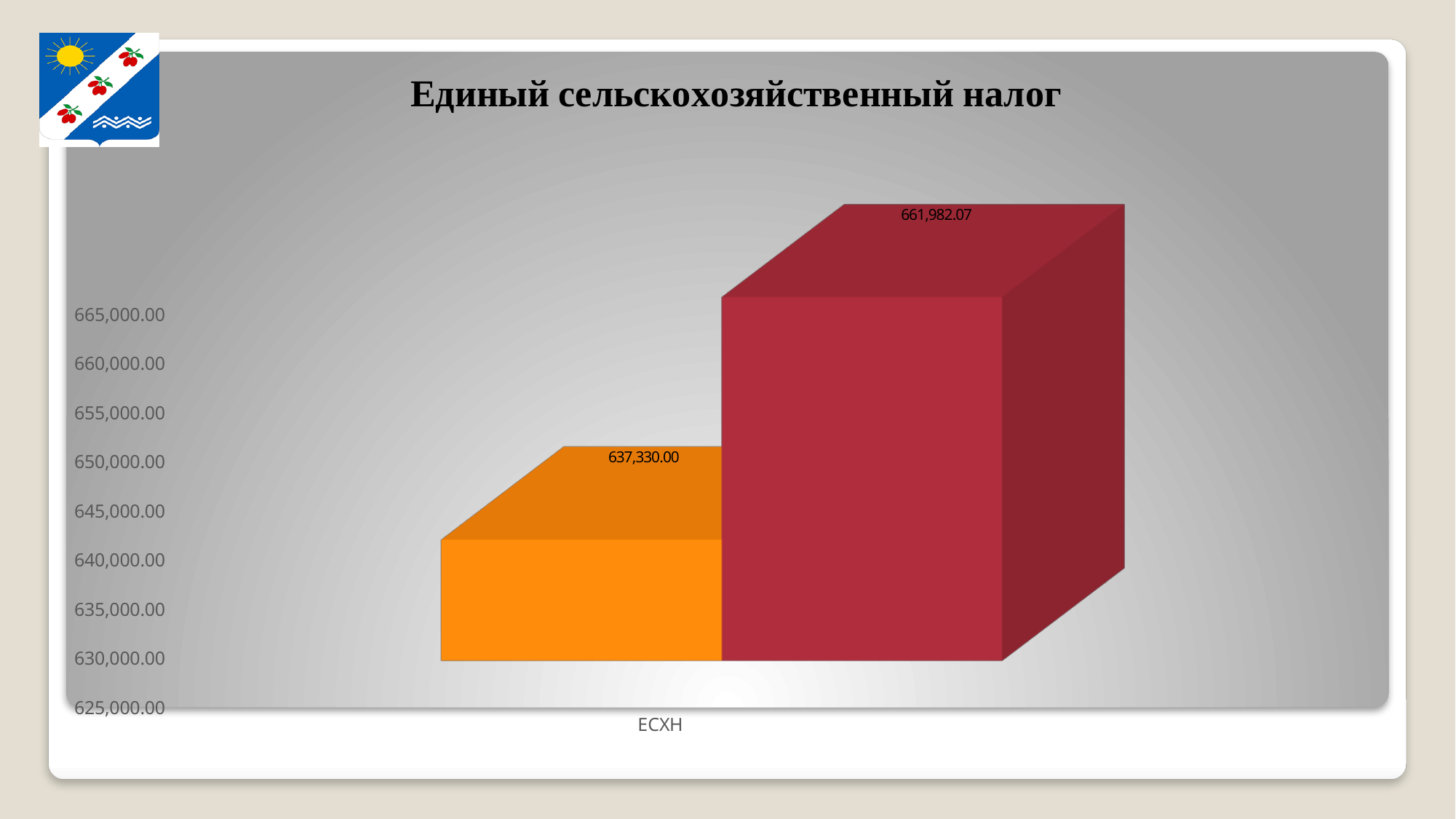
What is the value shown on the orange bar for ЕСХН? 637,330.00 What is the title of the chart? Единый сельскохозяйственный налог What is the difference between the red bar value and the orange bar value? 24,652.07 Is the value of the orange bar greater or less than 640,000.00? less How many categories are shown on the x axis of the chart? 1 Is the value of the red bar greater or less than 660,000.00? greater What is the value shown on the red bar for ЕСХН? 661,982.07 Which bar has the highest value on the chart? the red bar (661,982.07) Which bar is taller, the orange bar or the red bar? the red bar What type of chart is shown on the slide? bar chart What is the label of the category on the x axis? ЕСХН Which bar has the lowest value on the chart? the orange bar (637,330.00)